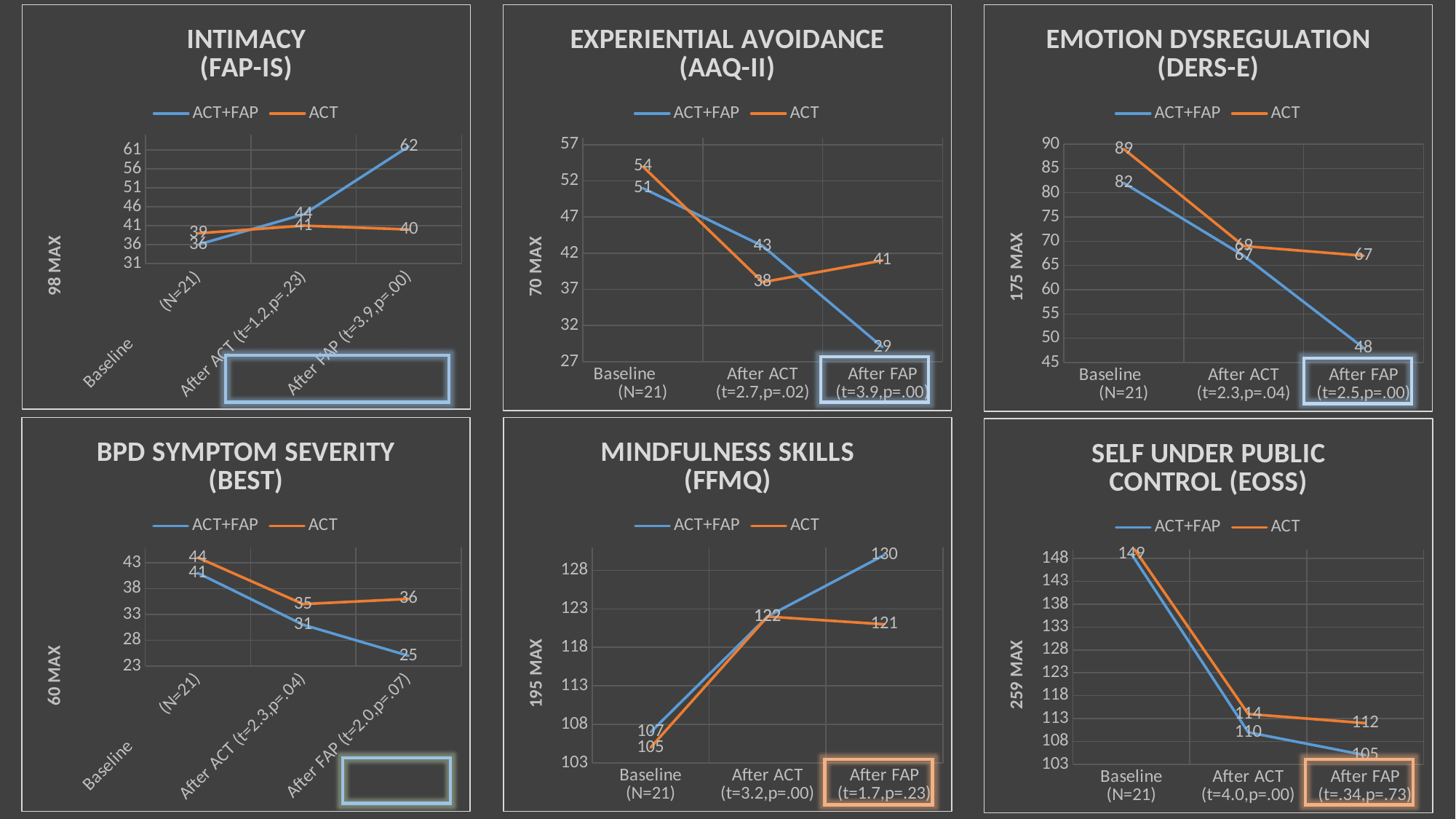
How many series does the legend list in the SELF UNDER PUBLIC CONTROL (EOSS) chart? 2 In the EXPERIENTIAL AVOIDANCE (AAQ-II) chart, what is the value for ACT after ACT? 38 In the MINDFULNESS SKILLS (FFMQ) chart, what is the highest value plotted for ACT+FAP? 130 In the SELF UNDER PUBLIC CONTROL (EOSS) chart, what is the value for ACT after ACT? 114 What kind of chart is the MINDFULNESS SKILLS (FFMQ) chart? line chart In the INTIMACY (FAP-IS) chart, what is the difference between the ACT+FAP and ACT values after FAP? 22 In the EXPERIENTIAL AVOIDANCE (AAQ-II) chart, which series has the lower value after FAP? ACT+FAP In the INTIMACY (FAP-IS) chart, what is the value for ACT+FAP after FAP? 62 In the BPD SYMPTOM SEVERITY (BEST) chart, what is the value for ACT+FAP after FAP? 25 In the BPD SYMPTOM SEVERITY (BEST) chart, what is the difference between the ACT and ACT+FAP values after ACT? 4 In the EMOTION DYSREGULATION (DERS-E) chart, what is the baseline value for ACT? 89 In the EMOTION DYSREGULATION (DERS-E) chart, does the ACT+FAP line rise or fall from baseline to after FAP? fall